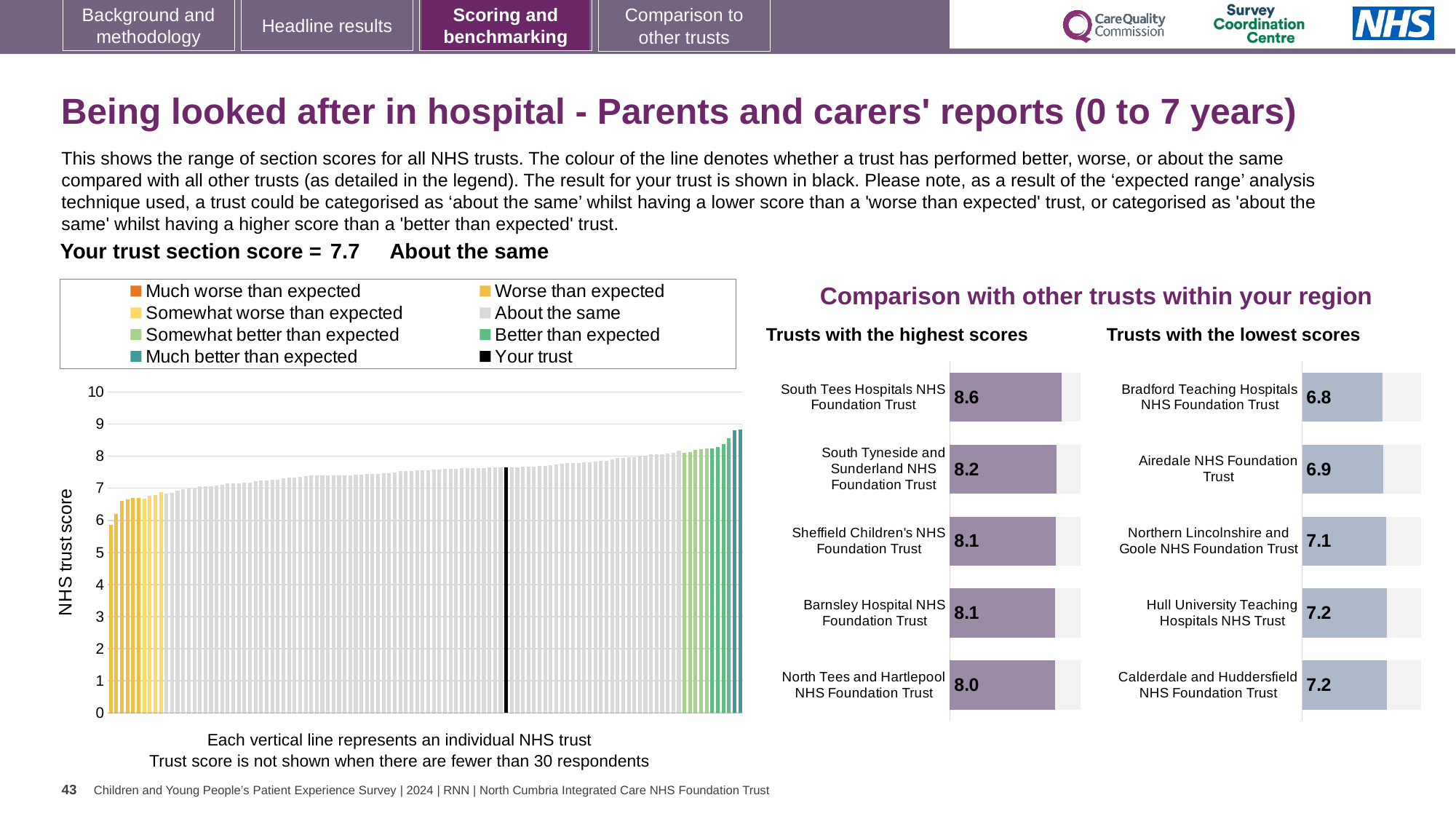
In the 'Trusts with the lowest scores' chart, which trust has the lowest score? Bradford Teaching Hospitals NHS Foundation Trust How many entries does the legend of the large chart on the left list? 8 In the 'Trusts with the highest scores' chart, what is the score for South Tees Hospitals NHS Foundation Trust? 8.6 In the 'Trusts with the lowest scores' chart, which has the higher score: Airedale NHS Foundation Trust or Northern Lincolnshire and Goole NHS Foundation Trust? Northern Lincolnshire and Goole NHS Foundation Trust How many trusts are listed in the 'Trusts with the highest scores' chart? 5 In the 'Trusts with the highest scores' chart, which trust has the highest score? South Tees Hospitals NHS Foundation Trust In the 'Trusts with the highest scores' chart, what is the difference between the scores of South Tees Hospitals NHS Foundation Trust and North Tees and Hartlepool NHS Foundation Trust? 0.6 In the large chart on the left showing all NHS trusts, what is the section score for your trust (the black line)? 7.7 In the large chart on the left showing all NHS trusts, is the value of the highest bar greater or less than 8? greater In the 'Trusts with the lowest scores' chart, what is the difference between the scores of Hull University Teaching Hospitals NHS Trust and Bradford Teaching Hospitals NHS Foundation Trust? 0.4 In the 'Trusts with the lowest scores' chart, what is the score for Bradford Teaching Hospitals NHS Foundation Trust? 6.8 In the 'Trusts with the highest scores' chart, what is the score for North Tees and Hartlepool NHS Foundation Trust? 8.0